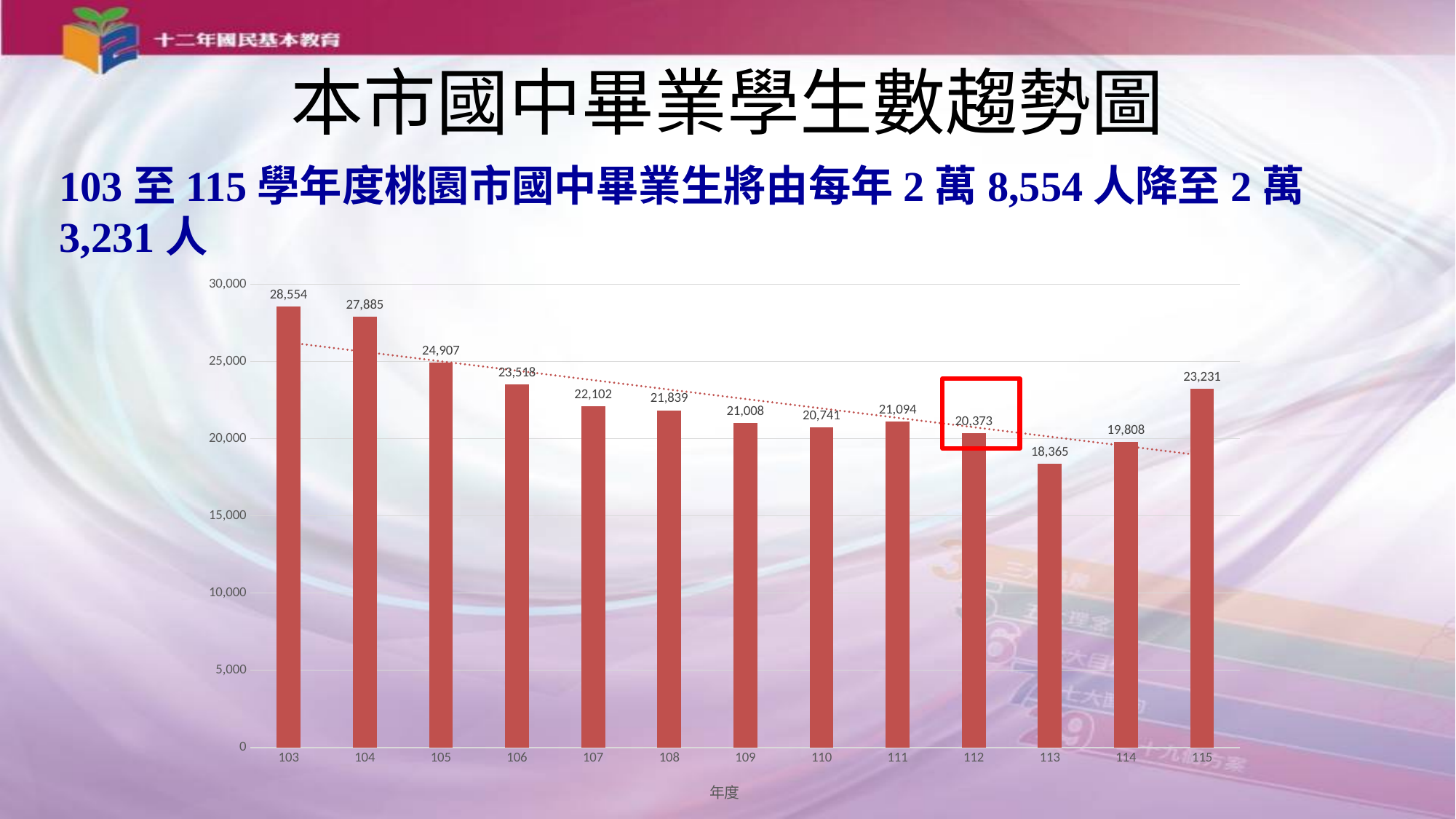
What kind of chart is this? bar chart Which is larger, the value for year 111 or the value for year 110? 111 What is the difference between the values for year 114 and year 113? 1,443 What is the difference between the values for year 103 and year 115? 5,323 Which year has the lowest value? 113 What is the value for year 115? 23,231 What is the value for year 113? 18,365 What is the value for year 103? 28,554 What is the value for year 112, the bar highlighted with a red box? 20,373 What is the x-axis title of the chart? 年度 How many years are shown on the x axis? 13 Which year has the highest value? 103